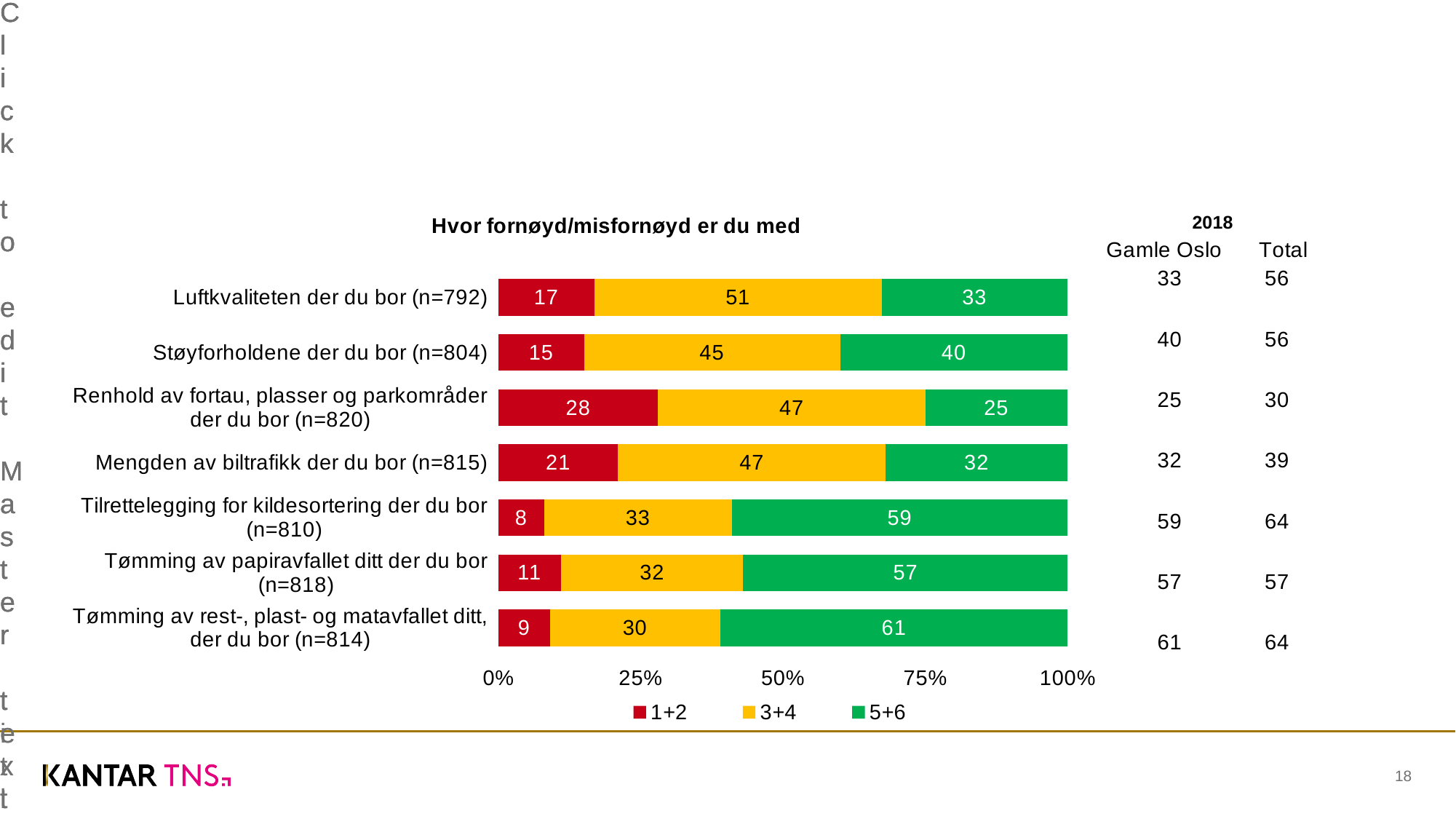
How many series does the legend list? 3 Which category has the lowest 1+2 value? Tilrettelegging for kildesortering der du bor (n=810) How many categories are plotted in the chart? 7 Which category has the highest 5+6 value? Tømming av rest-, plast- og matavfallet ditt, der du bor (n=814) What is the 3+4 value for "Støyforholdene der du bor (n=804)"? 45 What is the 1+2 value for "Renhold av fortau, plasser og parkområder der du bor (n=820)"? 28 Which colour represents the 1+2 series in the legend? Red What is the difference between the 5+6 values for "Tømming av papiravfallet ditt der du bor (n=818)" and "Mengden av biltrafikk der du bor (n=815)"? 25 Which is larger: the 3+4 value for "Luftkvaliteten der du bor (n=792)" or the 3+4 value for "Tilrettelegging for kildesortering der du bor (n=810)"? Luftkvaliteten der du bor (n=792) What is the title of the chart? Hvor fornøyd/misfornøyd er du med What kind of chart is shown on the slide? Stacked bar chart What is the 5+6 value for "Luftkvaliteten der du bor (n=792)"? 33